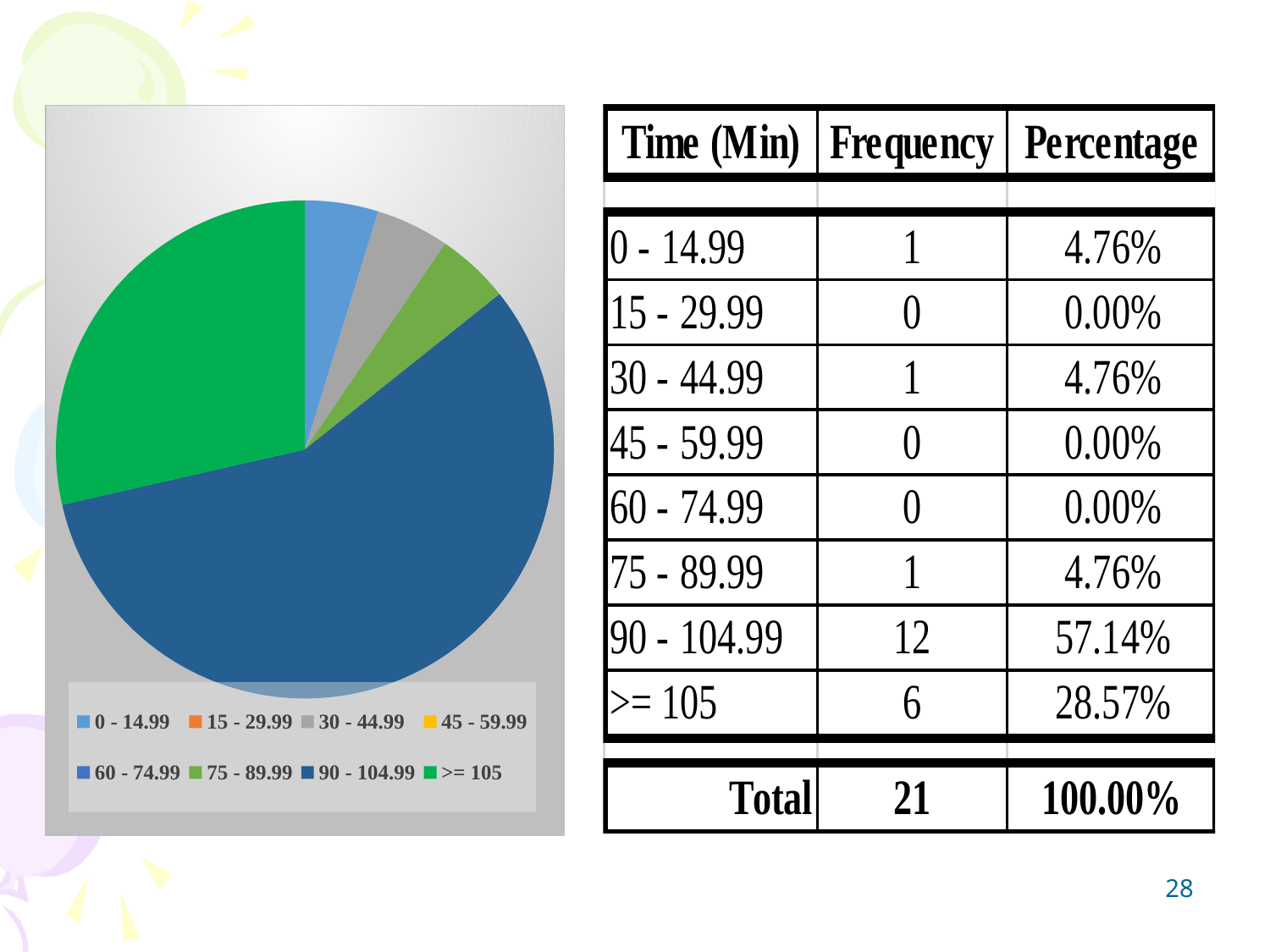
How many time intervals in the table have a frequency of 0? 3 How many categories does the pie chart's legend list? 8 What kind of chart is shown on the left of the slide? pie chart Which category has the largest slice in the pie chart? 90 - 104.99 According to the table, what is the frequency for the 90 - 104.99 time interval? 12 Which slice is larger in the pie chart, 90 - 104.99 or >= 105? 90 - 104.99 What share of the pie does the 90 - 104.99 slice represent, according to the table? 57.14% Which slice is larger in the pie chart, >= 105 or 0 - 14.99? >= 105 What is the total frequency shown in the table? 21 What is the difference in frequency between the 90 - 104.99 interval and the >= 105 interval? 6 What colour does the legend use for the >= 105 category? green According to the table, what percentage corresponds to the >= 105 interval? 28.57%